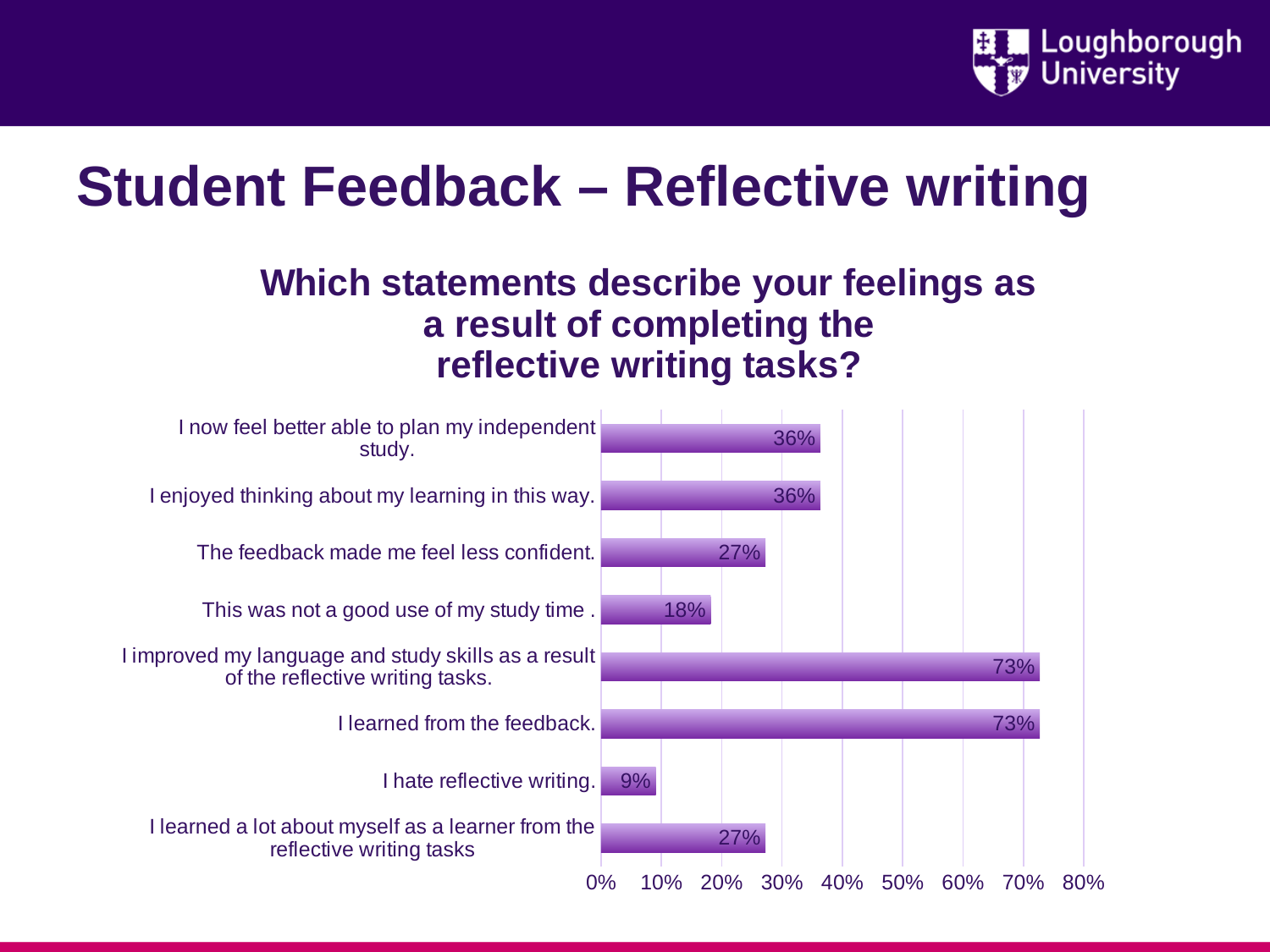
What is the difference between "I learned from the feedback." and "I hate reflective writing."? 64% What percentage of students said "The feedback made me feel less confident."? 27% What is the value for "I enjoyed thinking about my learning in this way."? 36% What is the value for "This was not a good use of my study time"? 18% What is the title of the chart? Which statements describe your feelings as a result of completing the reflective writing tasks? What percentage of students said "I hate reflective writing."? 9% What is the difference between "I now feel better able to plan my independent study." and "This was not a good use of my study time"? 18% How many statements are shown on the chart? 8 Which is larger: "I learned from the feedback." or "I learned a lot about myself as a learner from the reflective writing tasks"? I learned from the feedback. Which statement has the lowest percentage? I hate reflective writing. What kind of chart is shown on the slide? Bar chart What is the highest percentage shown on the chart? 73%